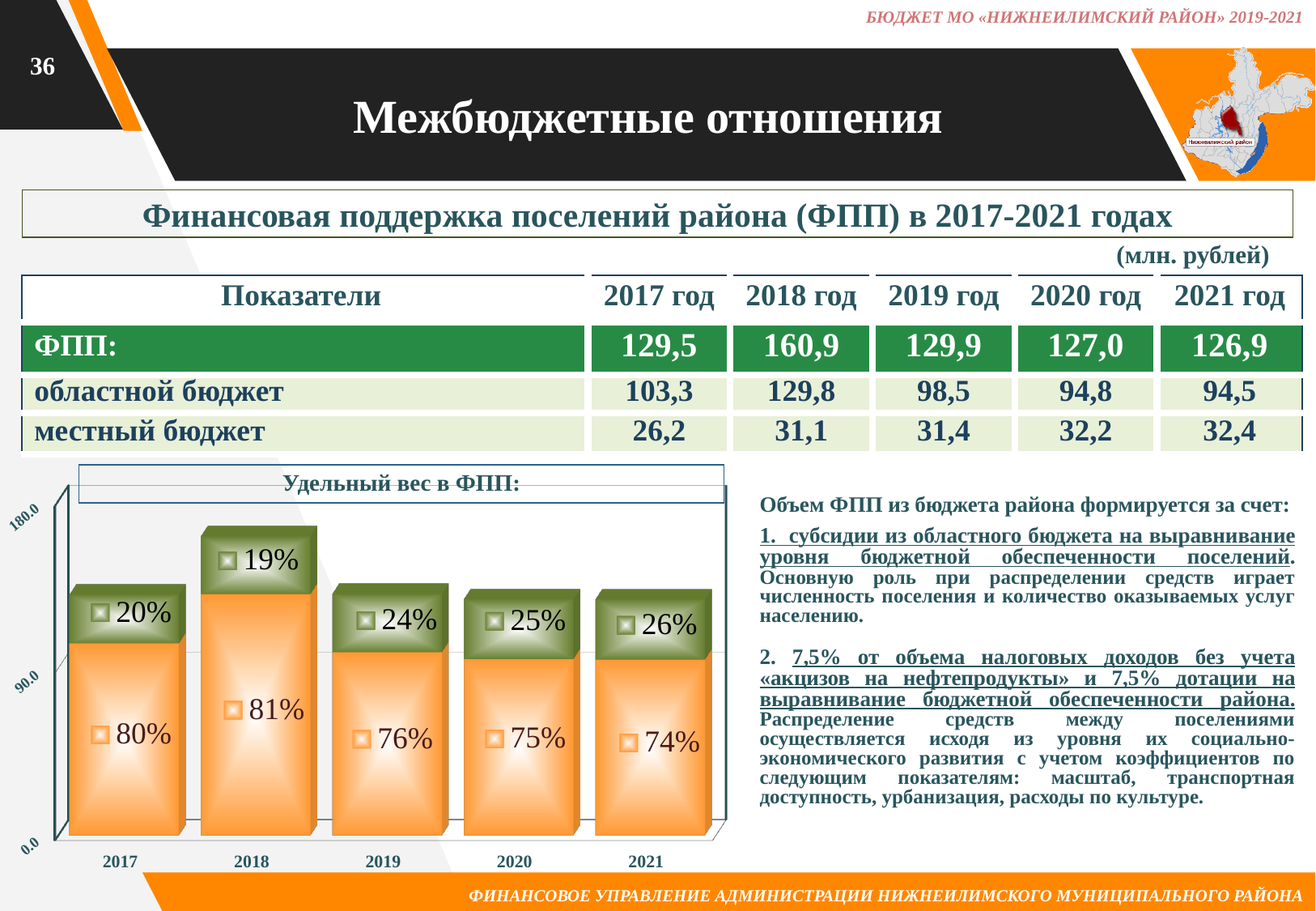
In the chart "Удельный вес в ФПП:", is the green segment value larger for 2019 or for 2021? 2021 In the chart "Удельный вес в ФПП:", what is the value of the green (upper) segment for 2018? 19% In the chart "Удельный вес в ФПП:", which year has the lowest value for the green (upper) segment? 2018 In the chart "Удельный вес в ФПП:", is the top of the 2018 bar greater or less than 90.0 on the vertical axis? greater What type of chart is shown under the heading "Удельный вес в ФПП:"? stacked bar chart In the chart "Удельный вес в ФПП:", what is the difference between the orange segment values for 2017 and 2021? 6 percentage points How many years are shown on the x axis of the chart "Удельный вес в ФПП:"? 5 In the chart "Удельный вес в ФПП:", which year has the highest value for the orange (lower) segment? 2018 In the chart "Удельный вес в ФПП:", what is the value of the orange (lower) segment for 2021? 74% In the chart "Удельный вес в ФПП:", what is the value of the green (upper) segment for 2020? 25% In the chart "Удельный вес в ФПП:", how does the green (upper) segment value change from 2018 to 2021? It rises In the chart "Удельный вес в ФПП:", what is the value of the orange (lower) segment for 2017? 80%